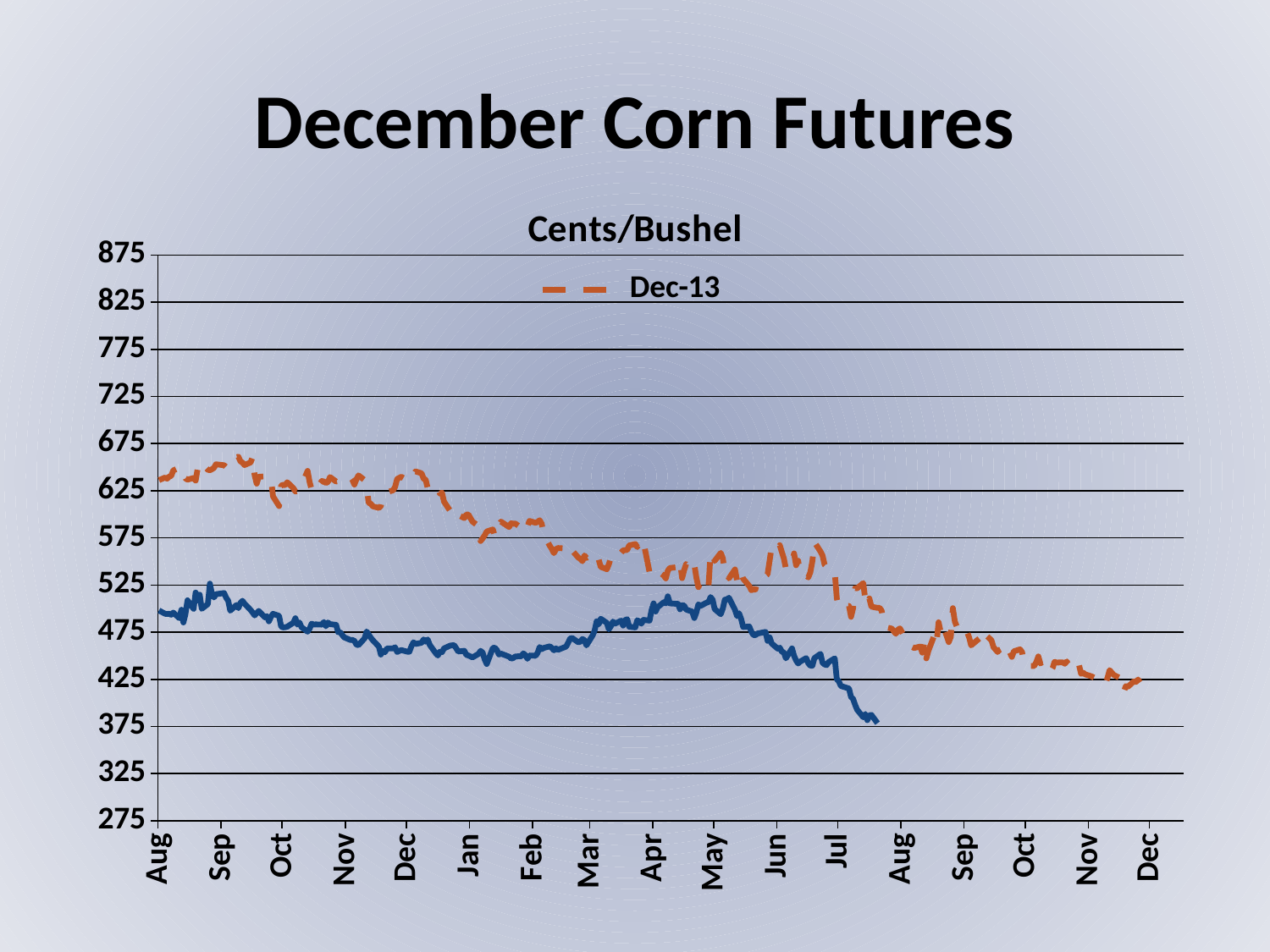
At the first Aug on the x axis, which is higher: the Dec-13 dashed line or the solid blue line? Dec-13 Is the value of the solid blue line at its end near Jul greater or less than 425? less Is the Dec-13 value at Mar greater or less than 575? less Does the solid blue line overall rise or fall from the first Aug to its end near Jul? fall How many month labels are shown along the x axis? 17 Does the Dec-13 series overall rise or fall from the first Aug to Dec on the x axis? fall What is the title printed above the chart's plot area? Cents/Bushel Is the Dec-13 value at the first Aug greater or less than 600? greater How many series does the chart legend list? 1 What is the name of the series shown in the legend? Dec-13 What kind of chart is shown on the slide? line chart